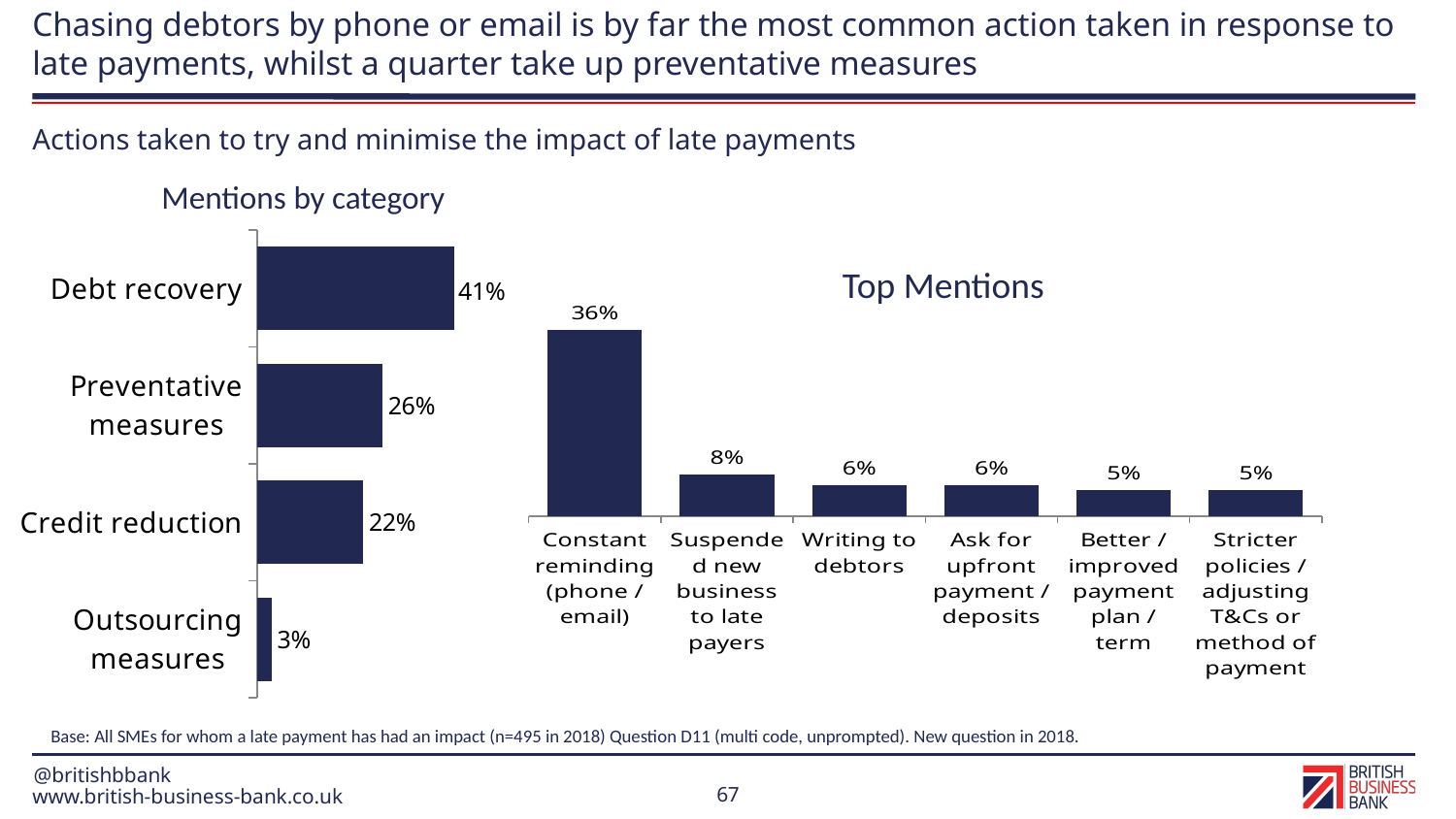
In the 'Top Mentions' chart, how many categories are shown? 6 In the 'Top Mentions' chart, which category has the highest value? Constant reminding (phone / email) In the 'Mentions by category' chart, what is the value for Debt recovery? 41% In the 'Top Mentions' chart, what is the value for Suspended new business to late payers? 8% In the 'Top Mentions' chart, what is the difference between Constant reminding (phone / email) and Writing to debtors? 30 percentage points In the 'Mentions by category' chart, how many categories are shown? 4 In the 'Mentions by category' chart, which category has the lowest value? Outsourcing measures In the 'Mentions by category' chart, what is the difference between Preventative measures and Credit reduction? 4 percentage points In the 'Top Mentions' chart, do the values rise or fall from left to right? Fall In the 'Mentions by category' chart, what is the value for Outsourcing measures? 3% What type of chart is the 'Mentions by category' chart? Bar chart In the 'Top Mentions' chart, what is the value for Constant reminding (phone / email)? 36%